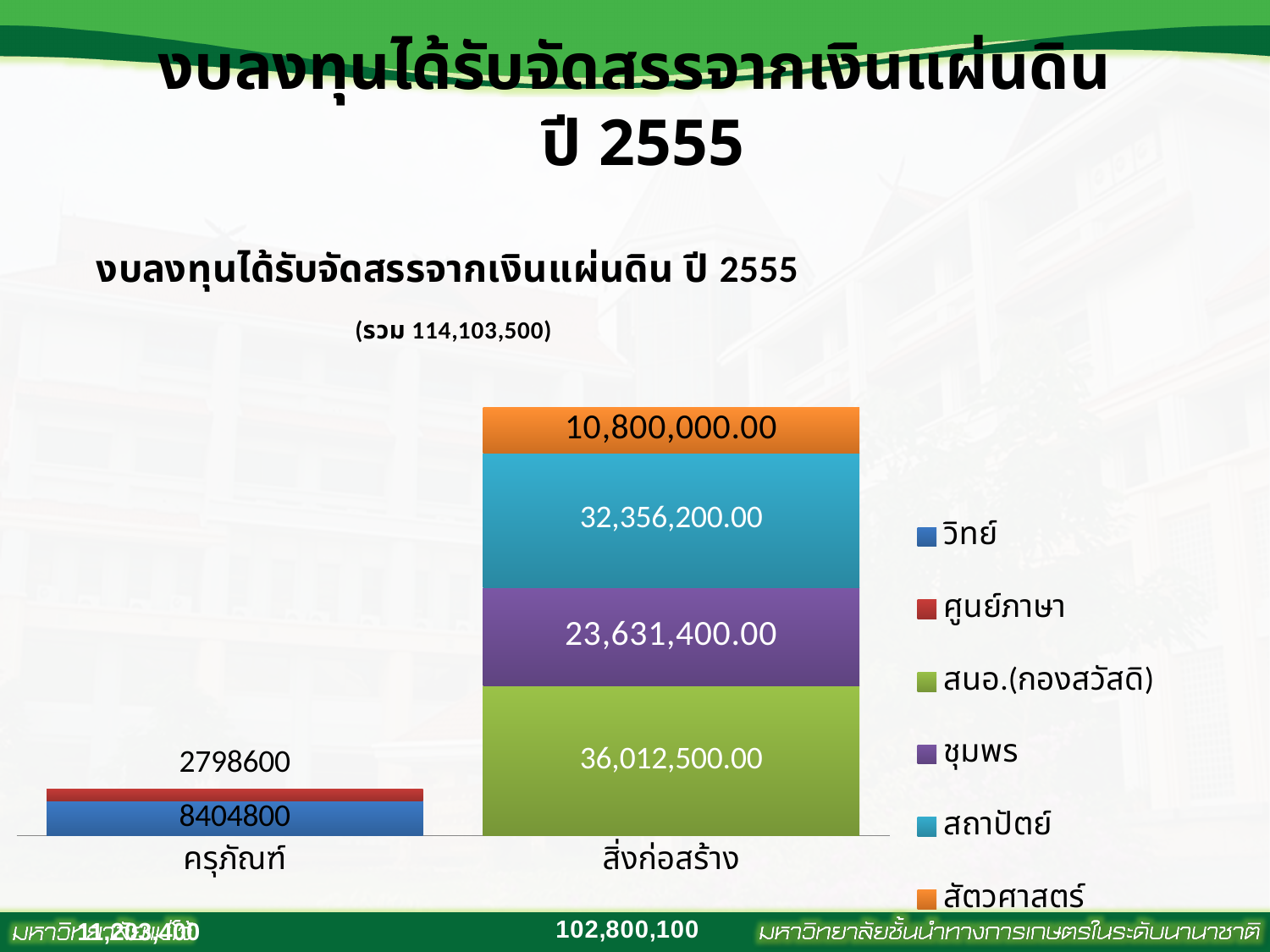
What is the value for ศูนย์ภาษา in the ครุภัณฑ์ bar? 2798600 What is the difference between the สนอ.(กองสวัสดิ) and สถาปัตย์ values in the สิ่งก่อสร้าง bar? 3,656,300.00 What is the value for ชุมพร in the สิ่งก่อสร้าง bar? 23,631,400.00 Which segment of the สิ่งก่อสร้าง bar has the largest value? สนอ.(กองสวัสดิ) How many categories are shown on the x axis? 2 What is the value for สนอ.(กองสวัสดิ) in the สิ่งก่อสร้าง bar? 36,012,500.00 How many series does the legend list? 6 What kind of chart is shown on the slide? Stacked bar chart What is the total of the สิ่งก่อสร้าง stacked bar? 102,800,100 What is the value for สัตวศาสตร์ in the สิ่งก่อสร้าง bar? 10,800,000.00 What is the value for สถาปัตย์ in the สิ่งก่อสร้าง bar? 32,356,200.00 What is the value for วิทย์ in the ครุภัณฑ์ bar? 8404800